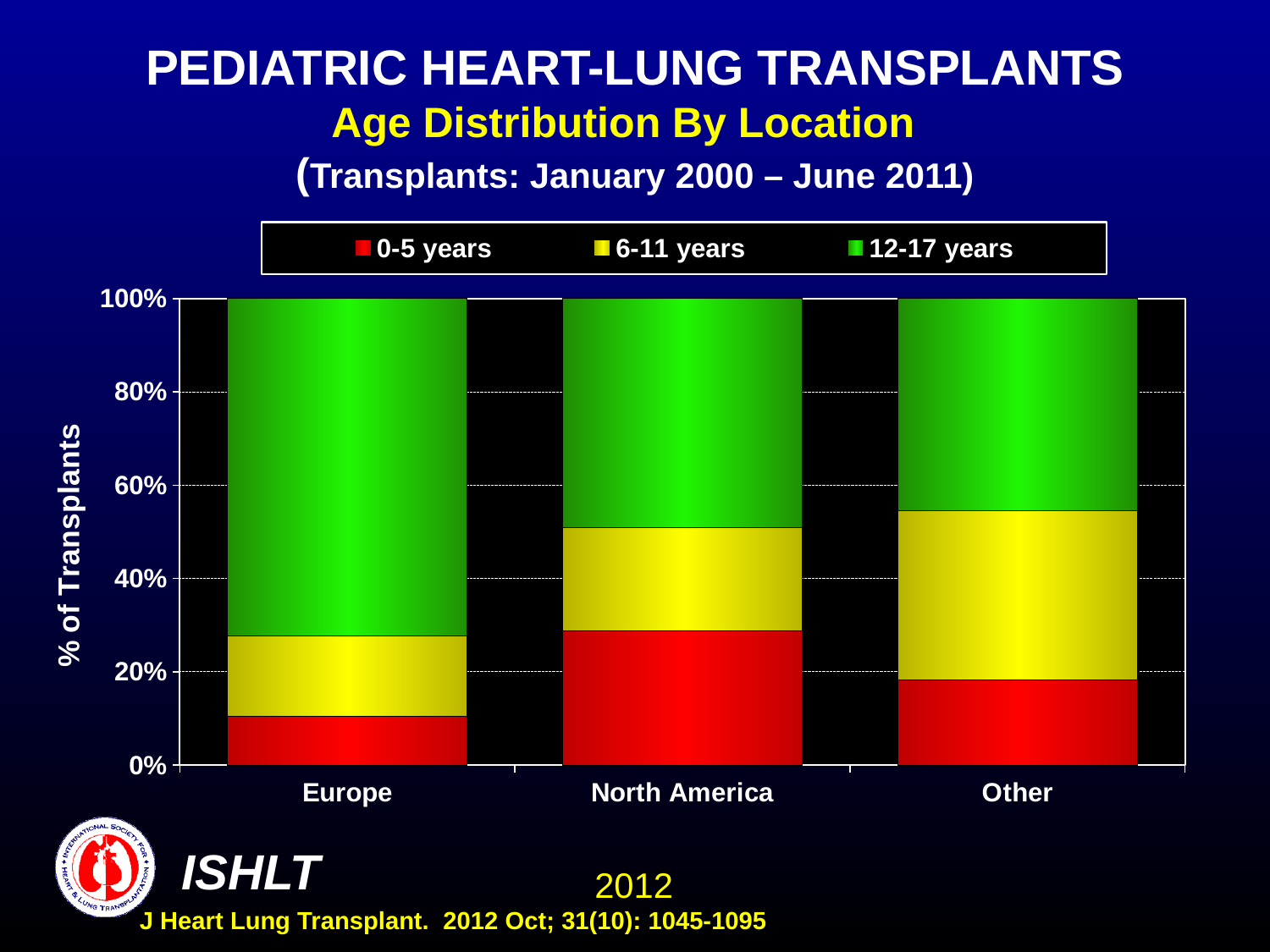
Which location has the largest share of transplants in the 12-17 years age group? Europe Which colour represents the 6-11 years age group in the legend? Yellow Which location has the largest share of transplants in the 0-5 years age group? North America Which location has the smallest share of transplants in the 0-5 years age group? Europe Is the 12-17 years share for North America greater or less than 60%? less What kind of chart is shown on the slide? Stacked bar chart What is the total height of the stacked bar for North America? 100% How many locations are shown on the x axis of the chart? 3 How many age groups does the legend list? 3 Which location has a larger 6-11 years share, Europe or Other? Other Is the 0-5 years share for Europe greater or less than 20%? less Is the 12-17 years share for Europe greater or less than 60%? greater